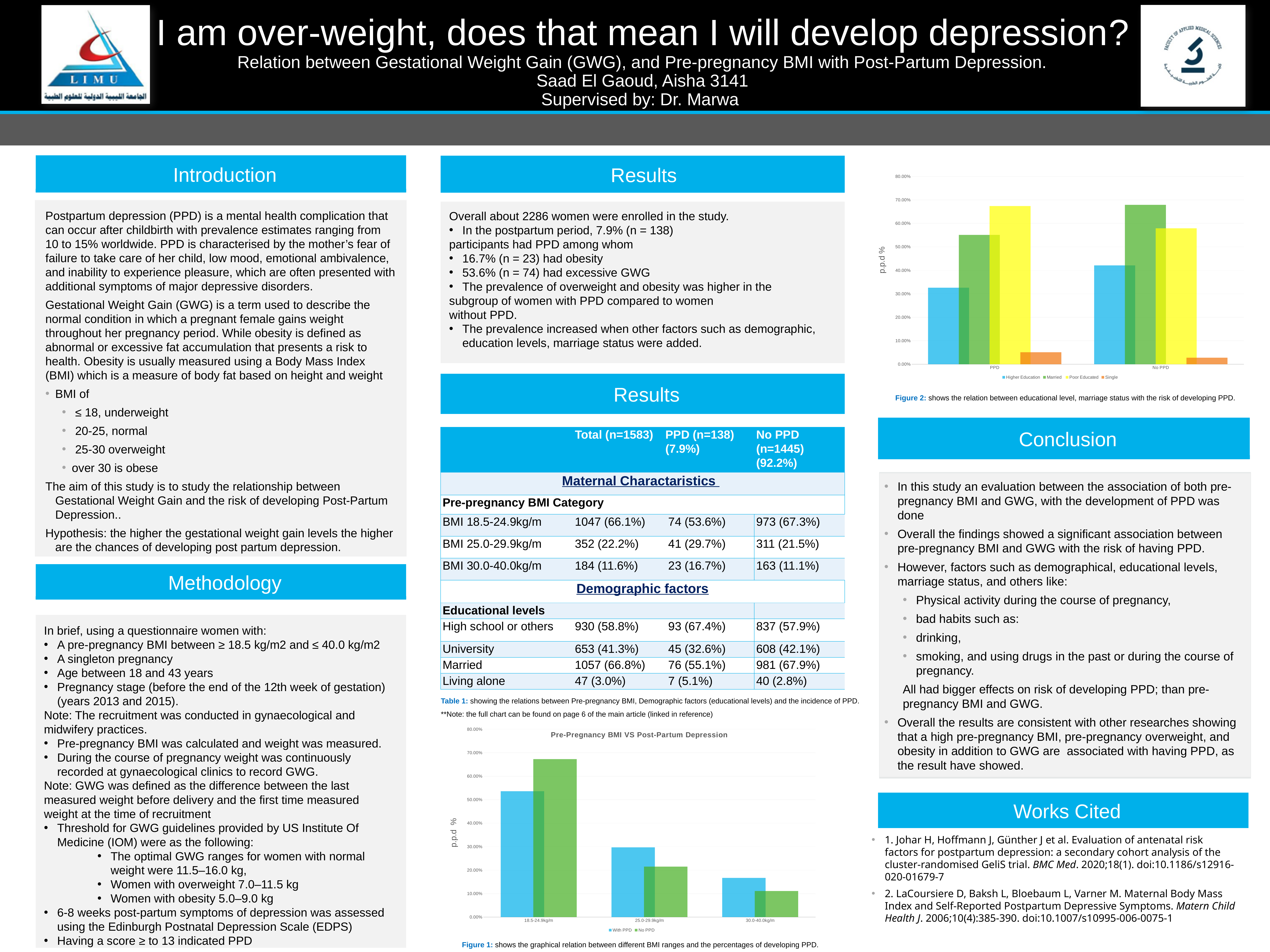
In the chart titled 'Pre-Pregnancy BMI VS Post-Partum Depression', is the 'No PPD' value for 18.5-24.9kg/m greater or less than 60.00%? greater In the chart at the top right of the slide (Figure 2), which series has the lowest value in the No PPD group? Single In the chart titled 'Pre-Pregnancy BMI VS Post-Partum Depression', for the 25.0-29.9kg/m category, which is larger: 'With PPD' or 'No PPD'? With PPD In the chart titled 'Pre-Pregnancy BMI VS Post-Partum Depression', how many BMI categories are shown on the x axis? 3 In the chart at the top right of the slide (Figure 2), how many series does the legend list? 4 In the chart titled 'Pre-Pregnancy BMI VS Post-Partum Depression', which BMI category has the highest 'No PPD' value? 18.5-24.9kg/m In the chart at the top right of the slide (Figure 2), is the 'Married' value for No PPD greater or less than 60.00%? greater In the chart at the top right of the slide (Figure 2), which series has the highest value in the PPD group? Poor Educated In the chart titled 'Pre-Pregnancy BMI VS Post-Partum Depression', how many series does the legend list? 2 In the chart titled 'Pre-Pregnancy BMI VS Post-Partum Depression', do the 'With PPD' values rise or fall from left to right along the x axis? fall In the chart titled 'Pre-Pregnancy BMI VS Post-Partum Depression', what kind of chart is shown? bar chart In the chart titled 'Pre-Pregnancy BMI VS Post-Partum Depression', which BMI category has the lowest 'With PPD' value? 30.0-40.0kg/m